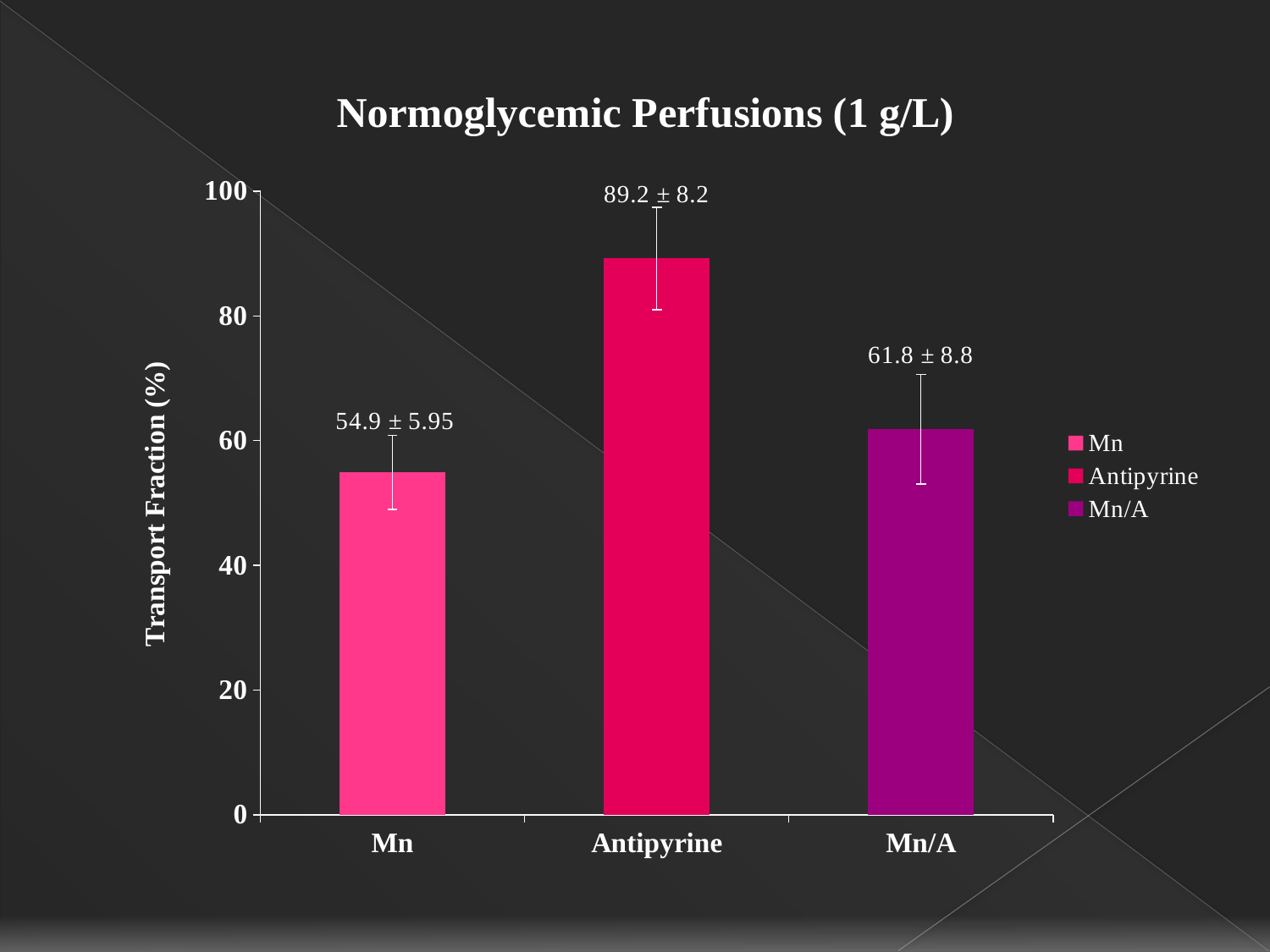
How many categories are shown on the x axis? 3 What is the transport fraction for Mn? 54.9 ± 5.95 What is the difference between the mean transport fraction of Mn/A and Mn? 6.9 What is the transport fraction for Antipyrine? 89.2 ± 8.2 What is the transport fraction for Mn/A? 61.8 ± 8.8 What kind of chart is shown on the slide? bar chart What is the difference between the mean transport fraction of Antipyrine and Mn? 34.3 What is the title of the chart? Normoglycemic Perfusions (1 g/L) Which category has the lowest transport fraction? Mn Is the transport fraction for Mn greater or less than 60? less Which has a larger transport fraction, Mn/A or Antipyrine? Antipyrine Which category has the highest transport fraction? Antipyrine